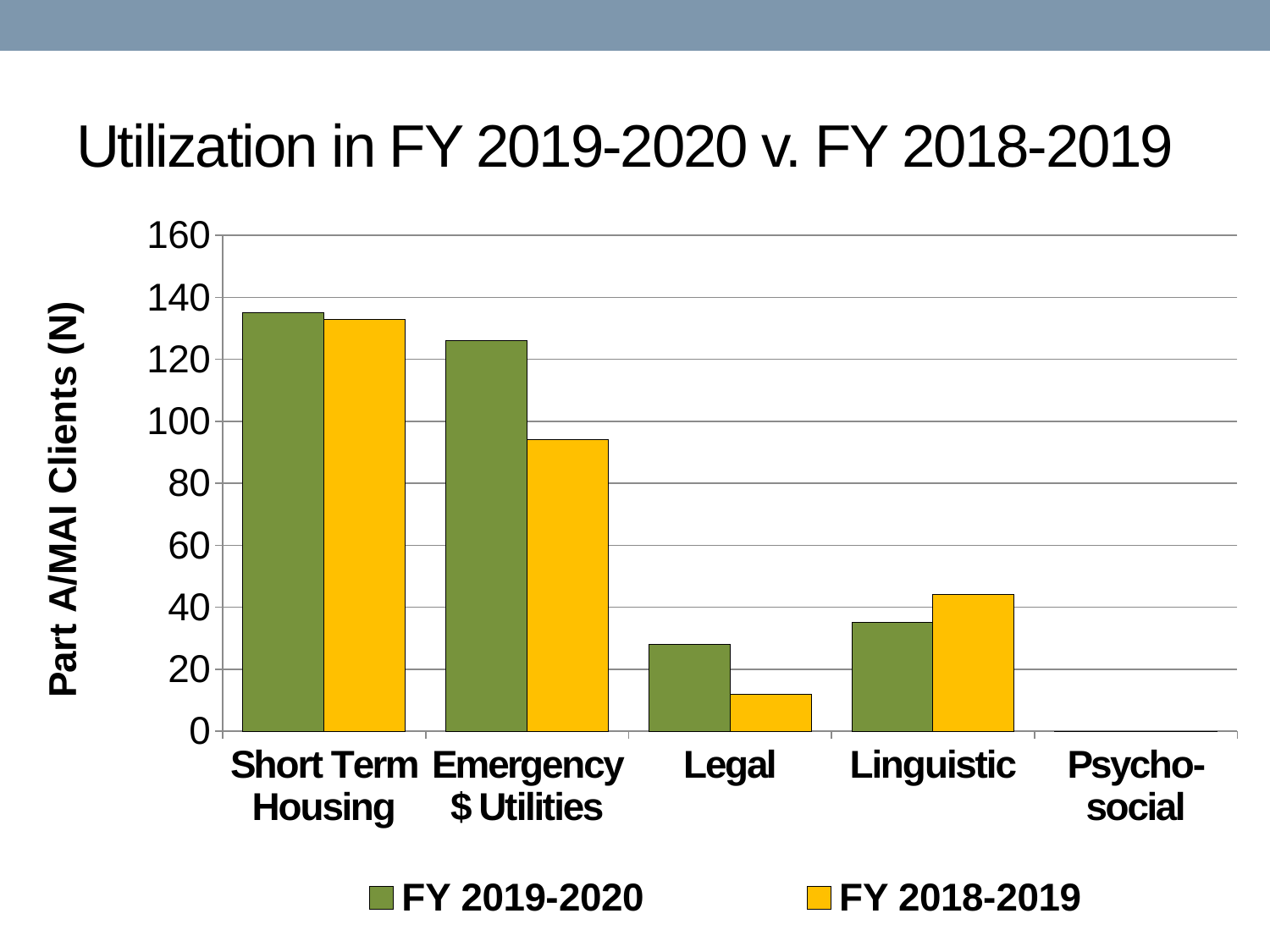
Which category has the highest FY 2019-2020 value? Short Term Housing What is the label on the y axis? Part A/MAI Clients (N) For Legal, which series has the larger value, FY 2019-2020 or FY 2018-2019? FY 2019-2020 Is the FY 2018-2019 value for Legal greater or less than 20? less Which category has the highest FY 2018-2019 value? Short Term Housing What kind of chart is shown on the slide? bar chart How many service categories are shown on the x axis? 5 How many series does the legend list? 2 Is the FY 2019-2020 value for Emergency $ Utilities greater or less than 120? greater Is the FY 2018-2019 value for Emergency $ Utilities greater or less than 100? less For Linguistic, which series has the larger value, FY 2019-2020 or FY 2018-2019? FY 2018-2019 What is the title of the chart? Utilization in FY 2019-2020 v. FY 2018-2019